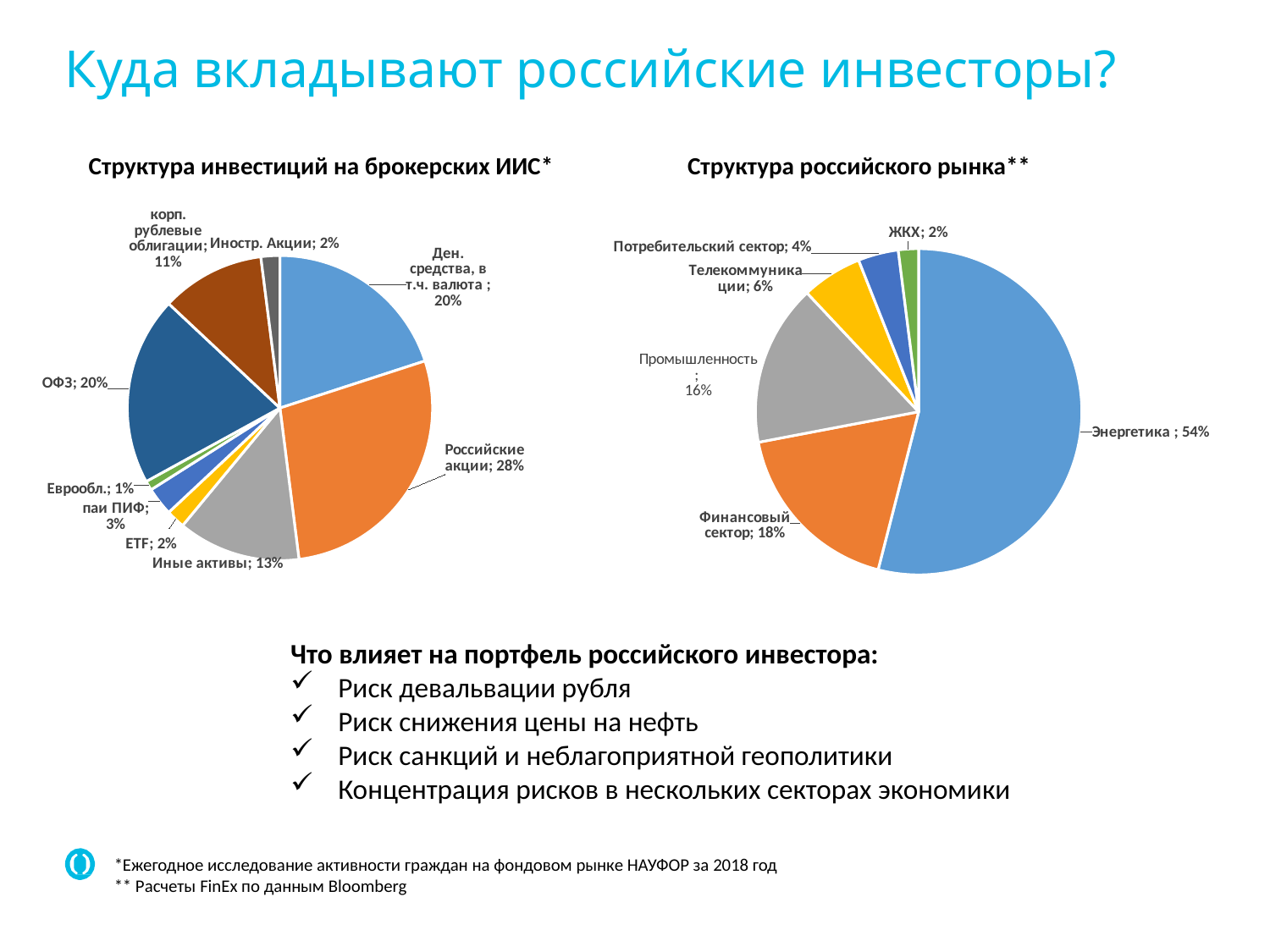
In the chart titled "Структура инвестиций на брокерских ИИС*", how many slices does the pie have? 9 In the chart titled "Структура инвестиций на брокерских ИИС*", what share do Российские акции have? 28% In the chart titled "Структура инвестиций на брокерских ИИС*", which category has the largest slice? Российские акции What type of chart is used for "Структура российского рынка**"? Pie chart In the chart titled "Структура российского рынка**", what share does Энергетика have? 54% In the chart titled "Структура инвестиций на брокерских ИИС*", which category has the smallest slice? Еврообл. In the chart titled "Структура российского рынка**", which is larger: Финансовый сектор or Телекоммуникации? Финансовый сектор In the chart titled "Структура российского рынка**", what share does Промышленность have? 16% In the chart titled "Структура инвестиций на брокерских ИИС*", what is the difference in percentage points between Российские акции and Иные активы? 15 In the chart titled "Структура инвестиций на брокерских ИИС*", what share do ОФЗ have? 20% In the chart titled "Структура российского рынка**", which sector has the smallest slice? ЖКХ In the chart titled "Структура российского рынка**", how many sectors are shown? 6